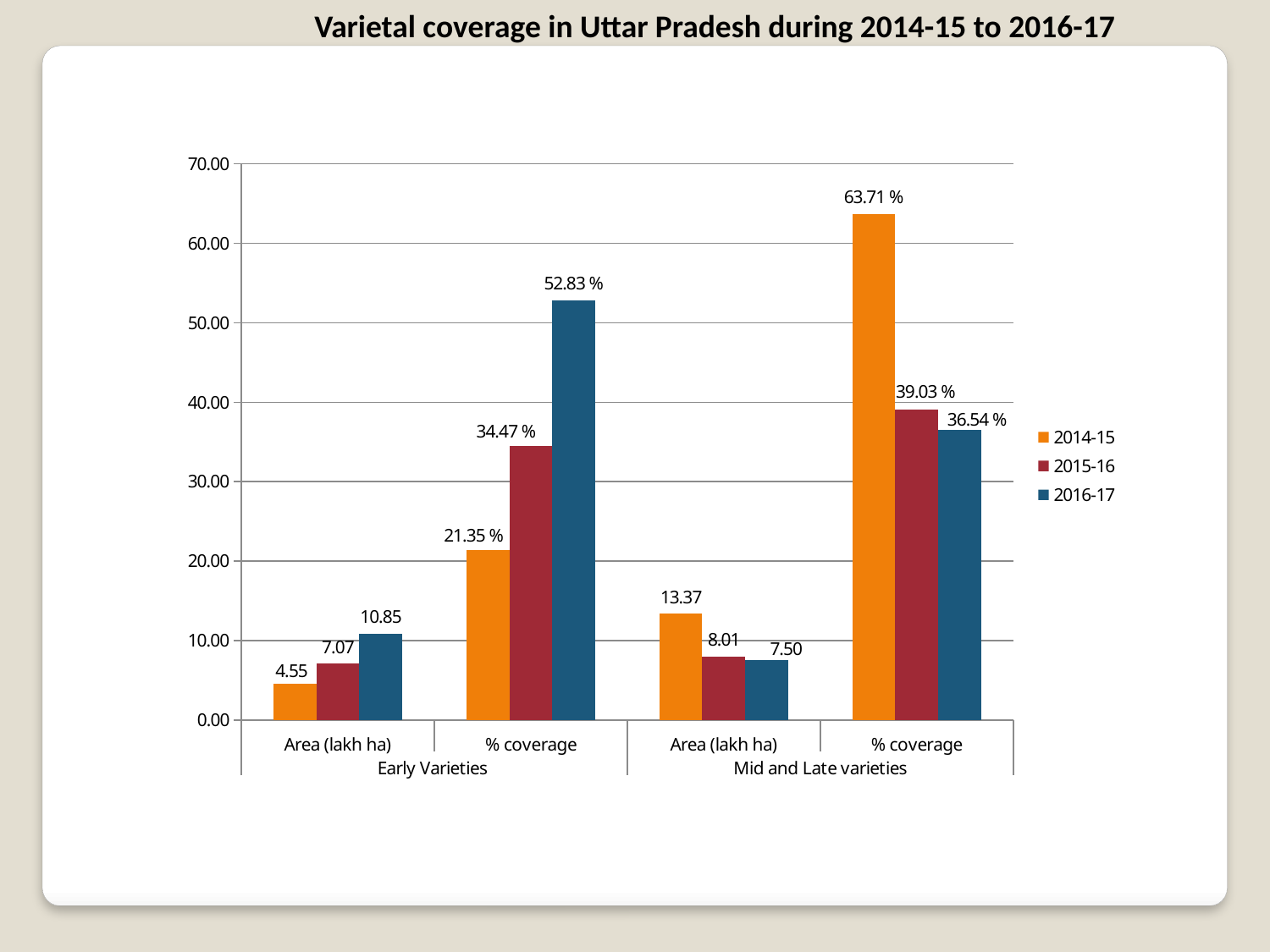
How many series does the legend list? 3 Which series has the highest % coverage for Mid and Late varieties? 2014-15 Which series has the lowest Area (lakh ha) for Early Varieties? 2014-15 Which is larger: the 2015-16 % coverage for Early Varieties or the 2015-16 % coverage for Mid and Late varieties? Mid and Late varieties What kind of chart is shown on the slide? Bar chart Do the % coverage values for Early Varieties rise or fall from 2014-15 to 2016-17? Rise What is the difference between the 2016-17 and 2014-15 Area (lakh ha) values for Early Varieties? 6.30 What is the 2015-16 value for Area (lakh ha) of Early Varieties? 7.07 What is the title of the chart? Varietal coverage in Uttar Pradesh during 2014-15 to 2016-17 What is the 2014-15 value for Area (lakh ha) of Mid and Late varieties? 13.37 Is the 2014-15 % coverage for Mid and Late varieties greater or less than 60.00? greater What is the 2016-17 value for % coverage of Early Varieties? 52.83 %